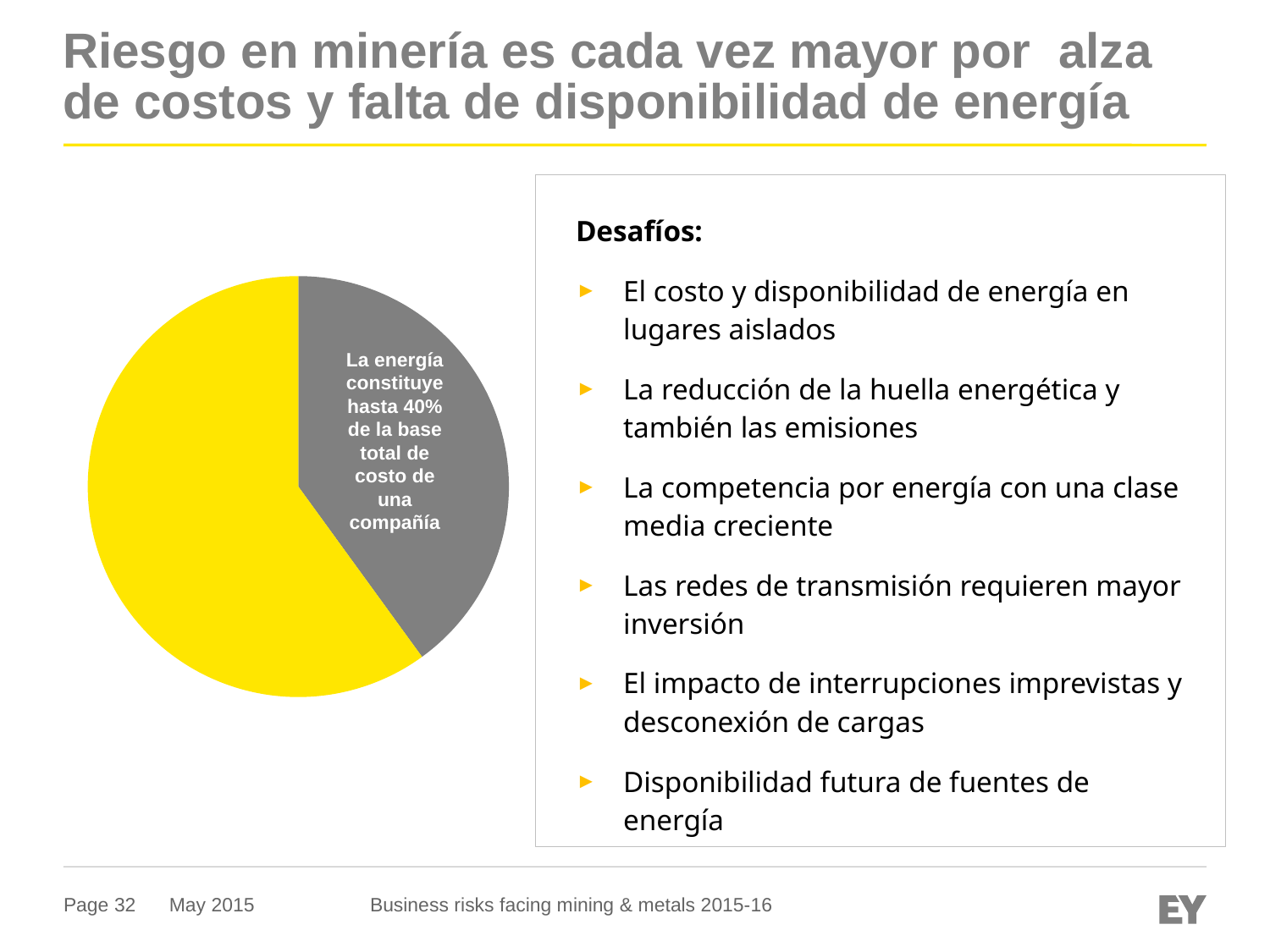
Which slice of the pie chart is larger, the yellow one or the grey one? The yellow one How many slices does the pie chart have? 2 What colour is the slice of the pie chart that carries the text label? Grey What kind of chart is shown on the left of the slide? Pie chart Is the yellow slice of the pie chart greater or less than half of the pie? greater According to the label on the grey slice, up to what percentage of a company's total cost base does energy constitute? 40% Is the grey slice of the pie chart greater or less than half of the pie? less Does the pie chart have a legend? No Which slice of the pie chart is the smallest? The grey slice